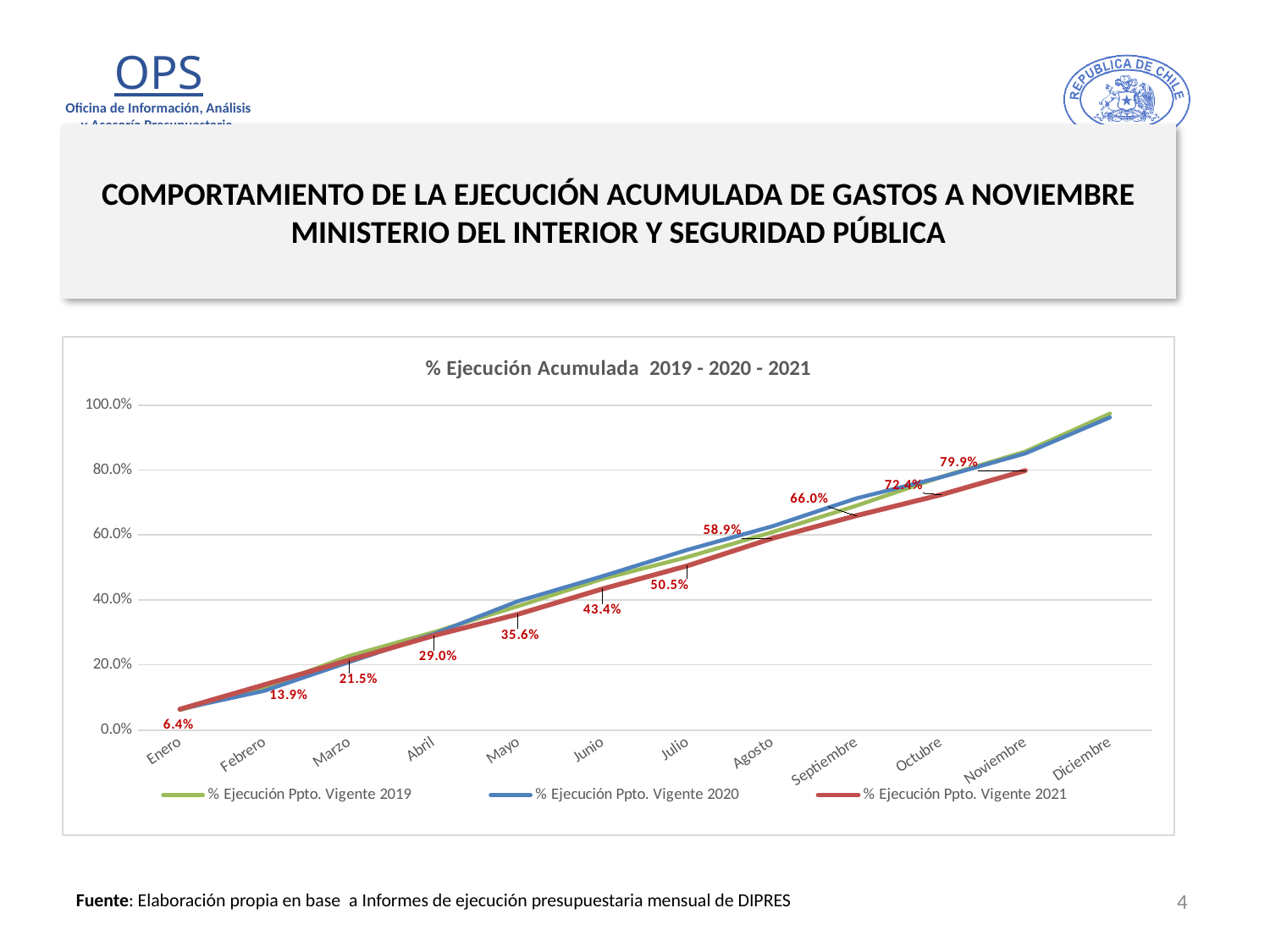
Is the value for % Ejecución Ppto. Vigente 2020 in Diciembre greater or less than 80.0%? greater How many series does the legend list? 3 How many months are shown along the x axis? 12 For the 2021 series, what is the difference between the Noviembre value and the Octubre value? 7.5 percentage points What is the value for % Ejecución Ppto. Vigente 2021 in Julio? 50.5% What is the value for % Ejecución Ppto. Vigente 2021 in Enero? 6.4% For the 2021 series, what is the difference between the Agosto value and the Julio value? 8.4 percentage points In Noviembre, which series has the larger value: % Ejecución Ppto. Vigente 2020 or % Ejecución Ppto. Vigente 2021? % Ejecución Ppto. Vigente 2020 What kind of chart is shown on the slide? line chart What is the title of the chart? % Ejecución Acumulada 2019 - 2020 - 2021 What is the value for % Ejecución Ppto. Vigente 2021 in Noviembre? 79.9% Do the values of the 2021 series rise or fall from Enero to Noviembre? rise